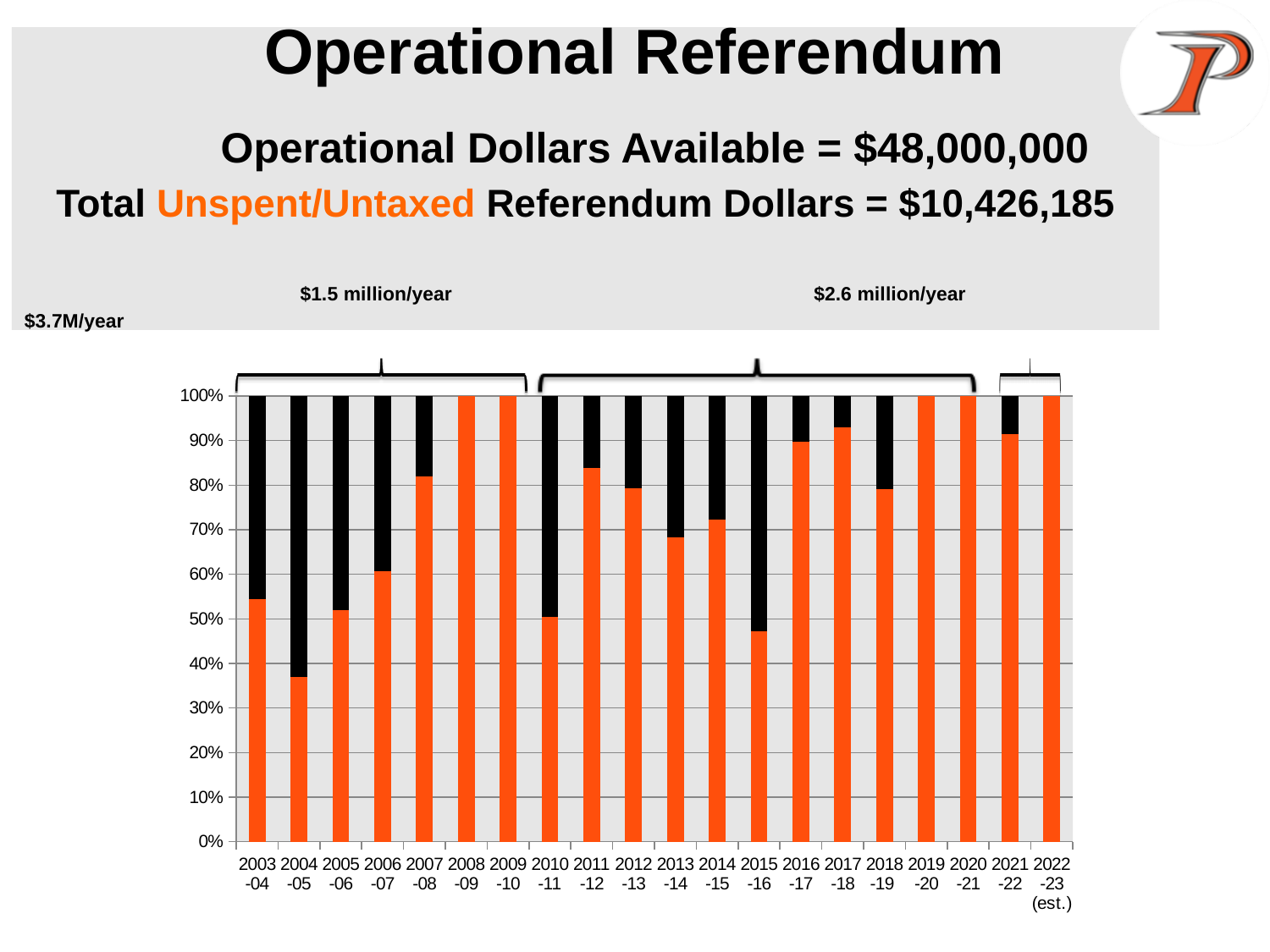
Is the orange segment for 2017-18 greater or less than 90%? greater Is the orange segment for 2004-05 greater or less than 40%? less Is the orange segment for 2015-16 greater or less than 50%? less Which year has the larger orange segment, 2016-17 or 2018-19? 2016-17 How many school-year categories are shown on the x axis of the chart? 20 Which year has the larger orange segment, 2012-13 or 2014-15? 2012-13 What kind of chart is shown on the slide? bar chart How many bars in the chart are entirely orange with no black segment? 5 What is the total height of each stacked bar in the chart? 100% Which year has the smallest orange segment in the chart? 2004-05